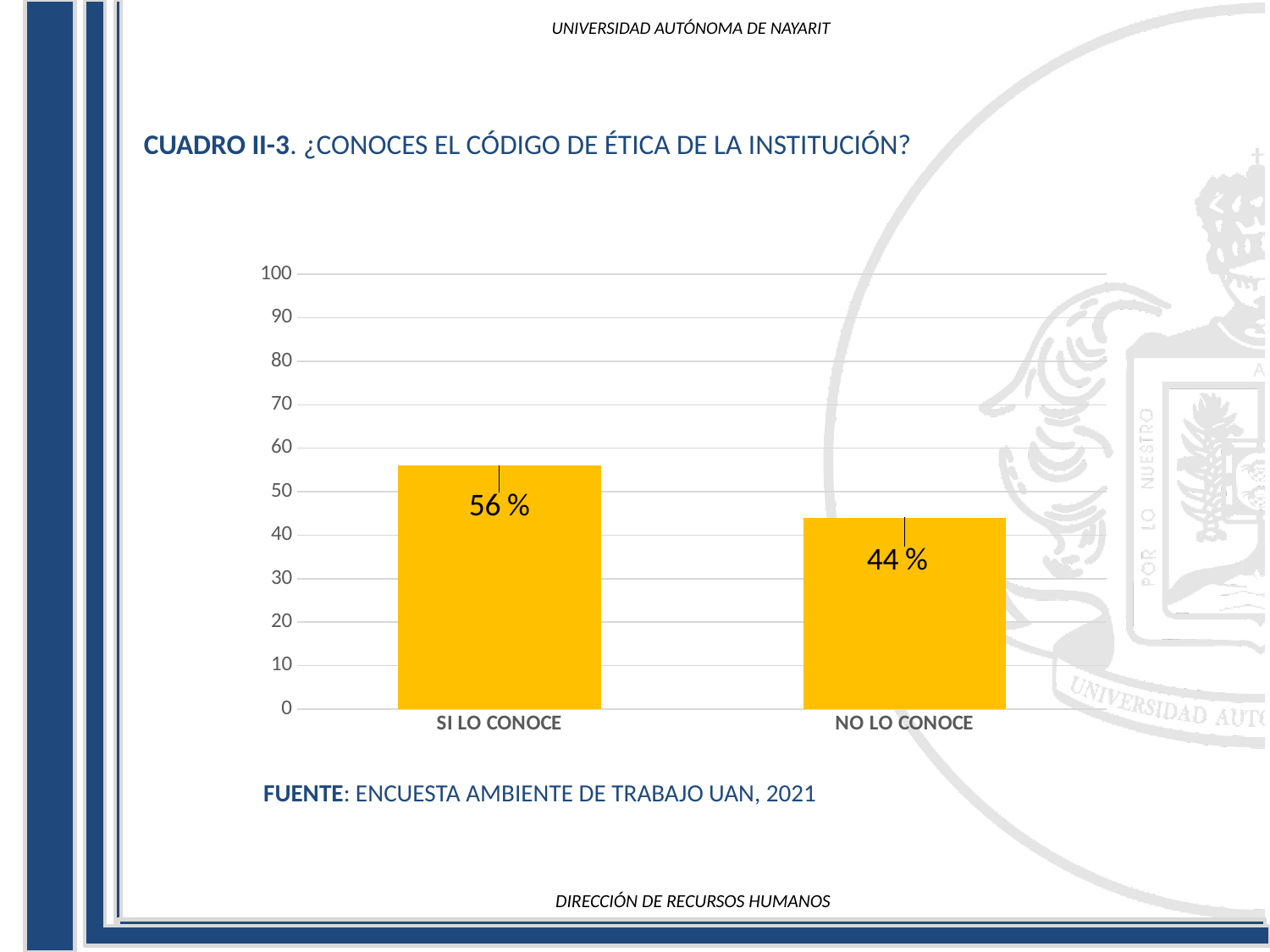
What source is cited below the chart? ENCUESTA AMBIENTE DE TRABAJO UAN, 2021 Which is larger, the value for SI LO CONOCE or the value for NO LO CONOCE? SI LO CONOCE What is the maximum value shown on the vertical axis? 100 What is the value for SI LO CONOCE? 56 % How many categories are shown in the chart? 2 Which category has the lowest value? NO LO CONOCE What is the value for NO LO CONOCE? 44 % Is the value for NO LO CONOCE greater or less than 50? less Which category has the highest value? SI LO CONOCE What is the difference between the values for SI LO CONOCE and NO LO CONOCE? 12 % Is the value for SI LO CONOCE greater or less than 50? greater What kind of chart is shown on the slide? bar chart